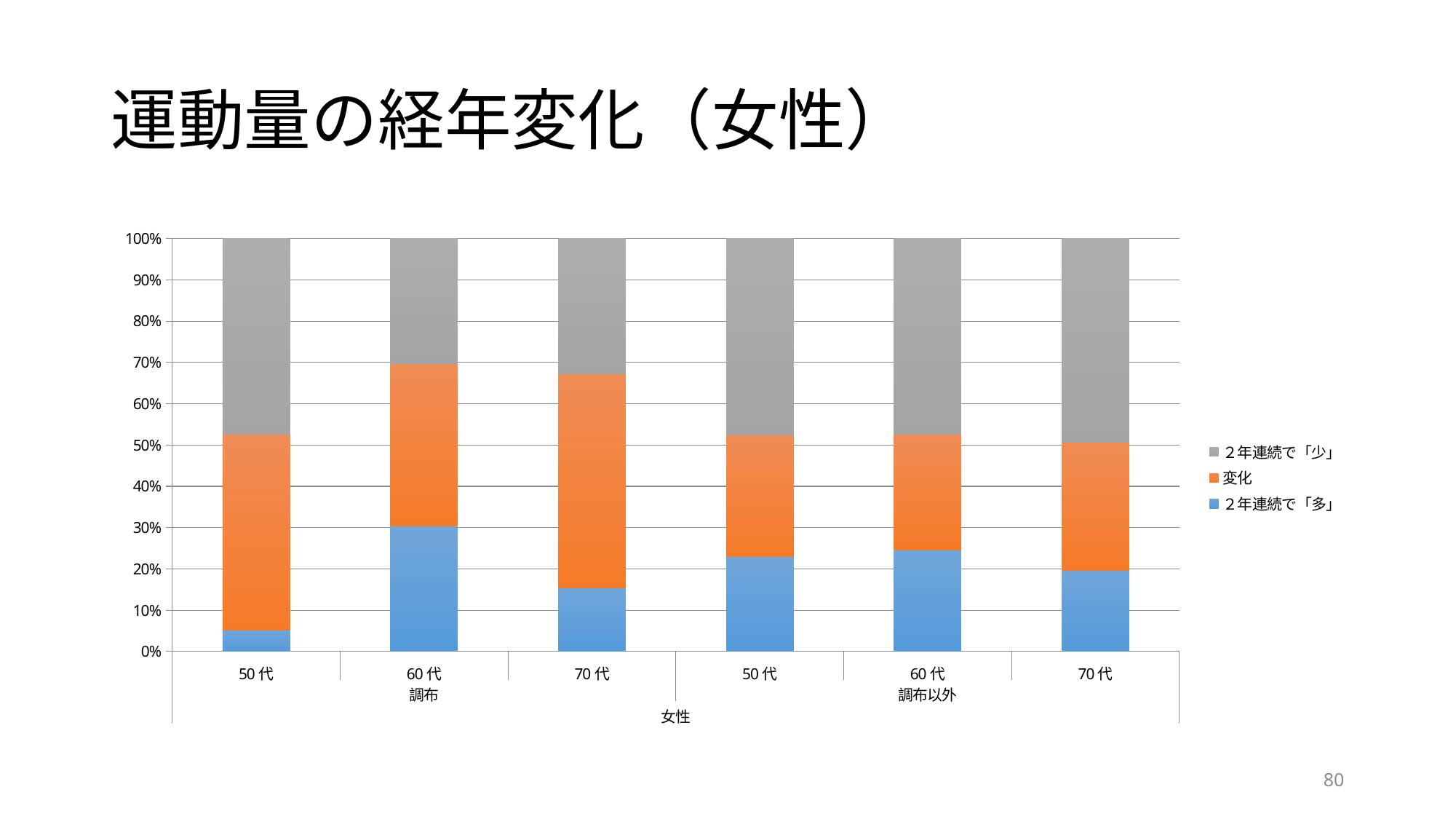
What kind of chart is shown on the slide? Stacked bar chart Is the 2年連続で「少」 share for 調布以外 50代 greater or less than 40%? greater Is the 2年連続で「多」 share for 調布 50代 greater or less than 10%? less How many series does the legend list? 3 Which category has the smallest share of 2年連続で「多」 (blue)? 調布 50代 Which has a larger 2年連続で「多」 share: 調布 70代 or 調布以外 50代? 調布以外 50代 Is the 2年連続で「少」 share for 調布 70代 greater or less than 40%? less What is the title of the slide? 運動量の経年変化（女性） How many bars are plotted in the chart? 6 Which series is shown in gray in the legend? 2年連続で「少」 Which category has the largest share of 2年連続で「多」 (blue)? 調布 60代